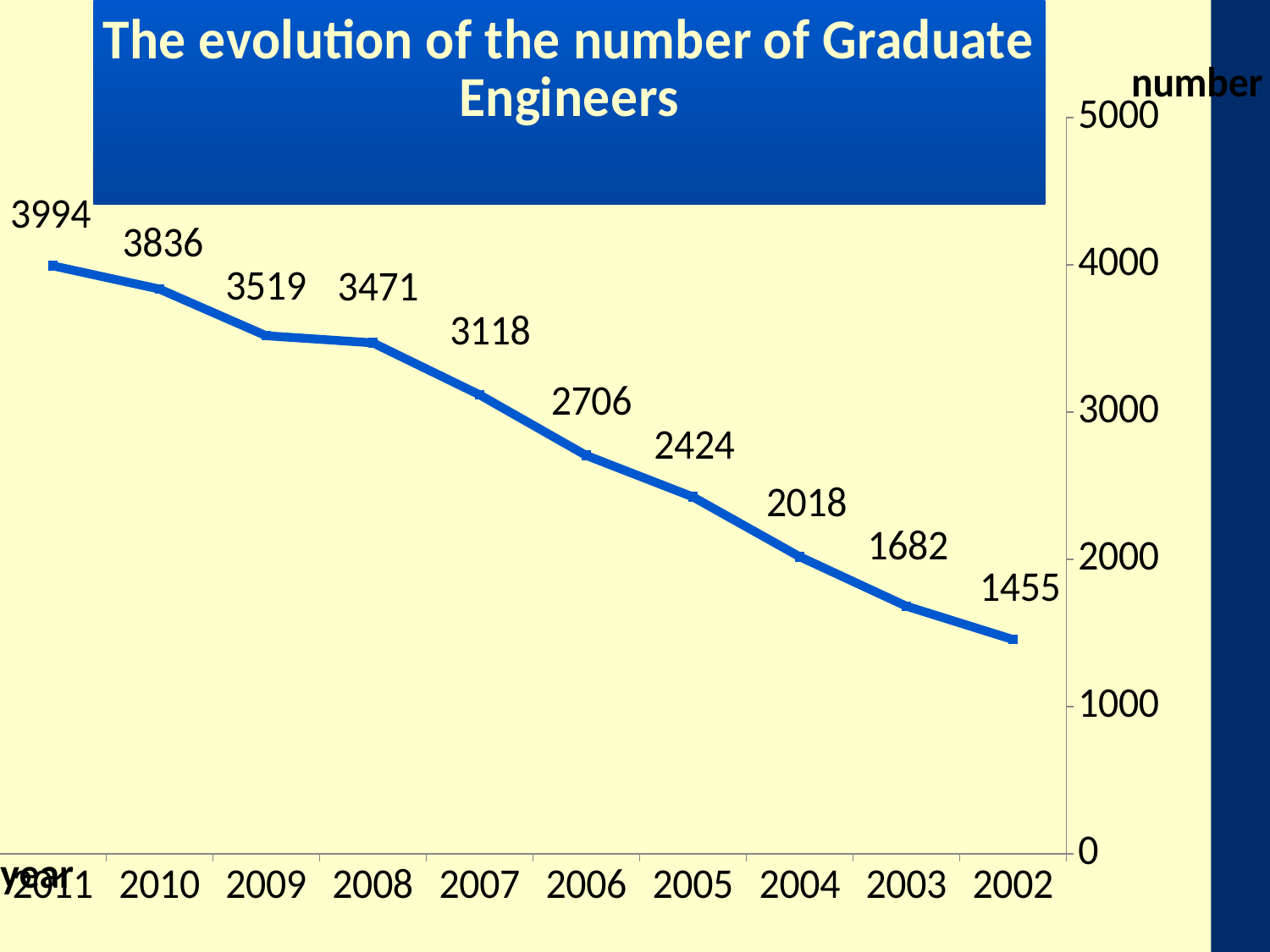
What is the number of graduate engineers for 2002? 1455 Which year has the larger value, 2006 or 2005? 2006 What value is plotted for 2004? 2018 Moving left to right along the x axis, do the plotted values rise or fall? fall What is the difference between the values for 2009 and 2008? 48 What kind of chart is shown on the slide? line chart Which year has the highest number of graduate engineers? 2011 What is the number of graduate engineers for 2011? 3994 What value is plotted for 2007? 3118 Which year has the lowest number of graduate engineers? 2002 What is the difference between the values for 2011 and 2002? 2539 How many years are plotted on the x axis? 10